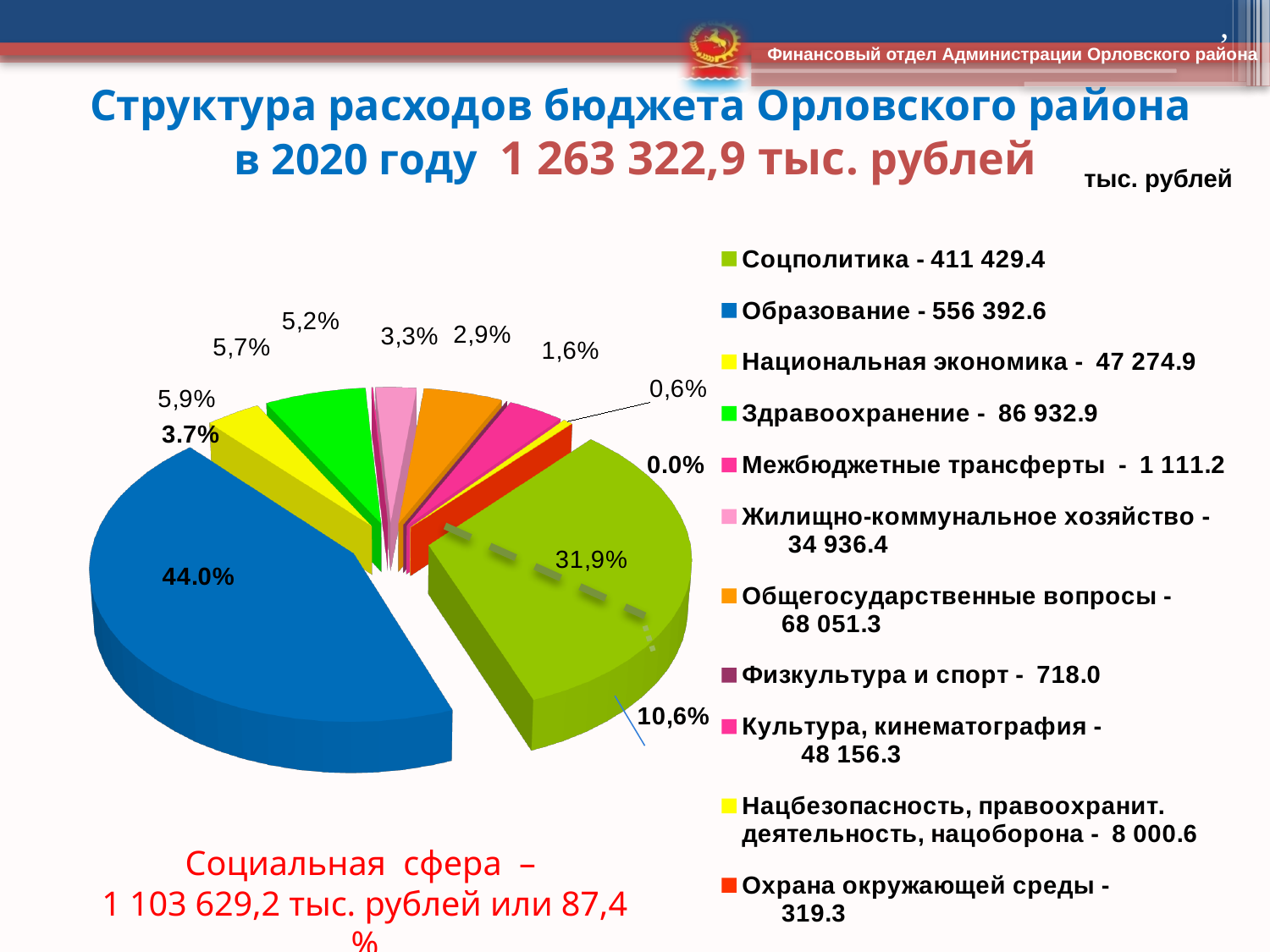
Which category has the largest value? Образование What is the value for Культура, кинематография? 48 156.3 What share of the pie does the Образование slice (the blue slice) represent? 44.0% What kind of chart is shown on the slide? Pie chart Which category has the smallest value? Охрана окружающей среды What total amount of budget expenditure is stated in the slide title? 1 263 322,9 тыс. рублей Which is larger: Соцполитика or Общегосударственные вопросы? Соцполитика What is the value for Образование in the legend? 556 392.6 How many categories does the legend of the pie chart list? 11 What is the value for Физкультура и спорт? 718.0 What is the difference between the values for Образование and Соцполитика? 144 963.2 What is the value for Здравоохранение in the legend? 86 932.9